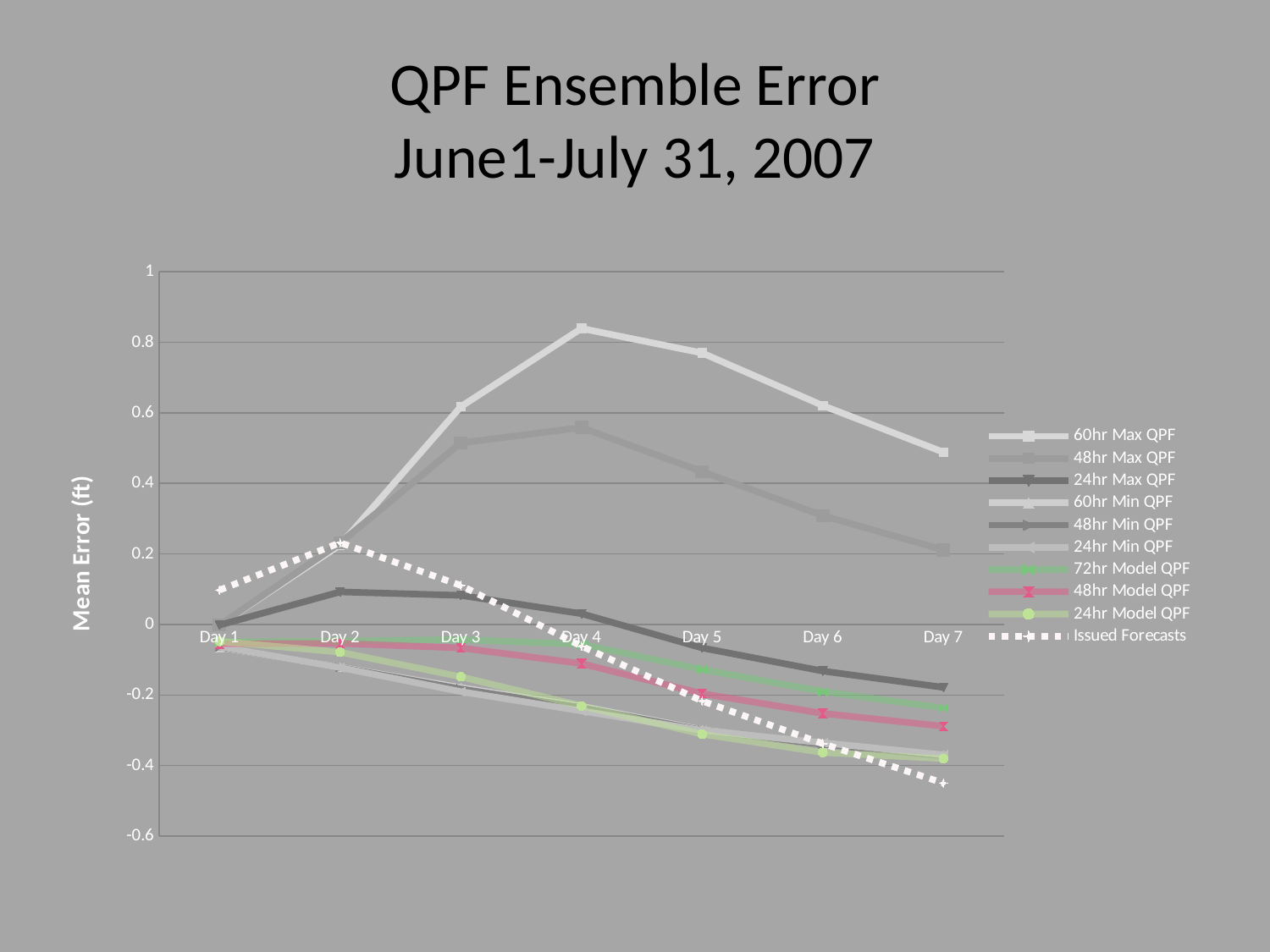
Does the 48hr Model QPF series rise or fall from Day 1 to Day 7? Fall How many days (categories) are plotted along the x axis? 7 Is the value for 60hr Max QPF on Day 7 greater or less than 0.4? greater What kind of chart is shown on the slide? Line chart How many series does the legend list? 10 On which day does the 60hr Max QPF series reach its highest value? Day 4 Is the value for Issued Forecasts on Day 7 greater or less than -0.4? less Is the value for 60hr Max QPF on Day 4 greater or less than 0.8? greater On Day 4, which is larger: 60hr Max QPF or 48hr Max QPF? 60hr Max QPF Which series has the lowest value on Day 7? Issued Forecasts What is the label of the vertical axis? Mean Error (ft)